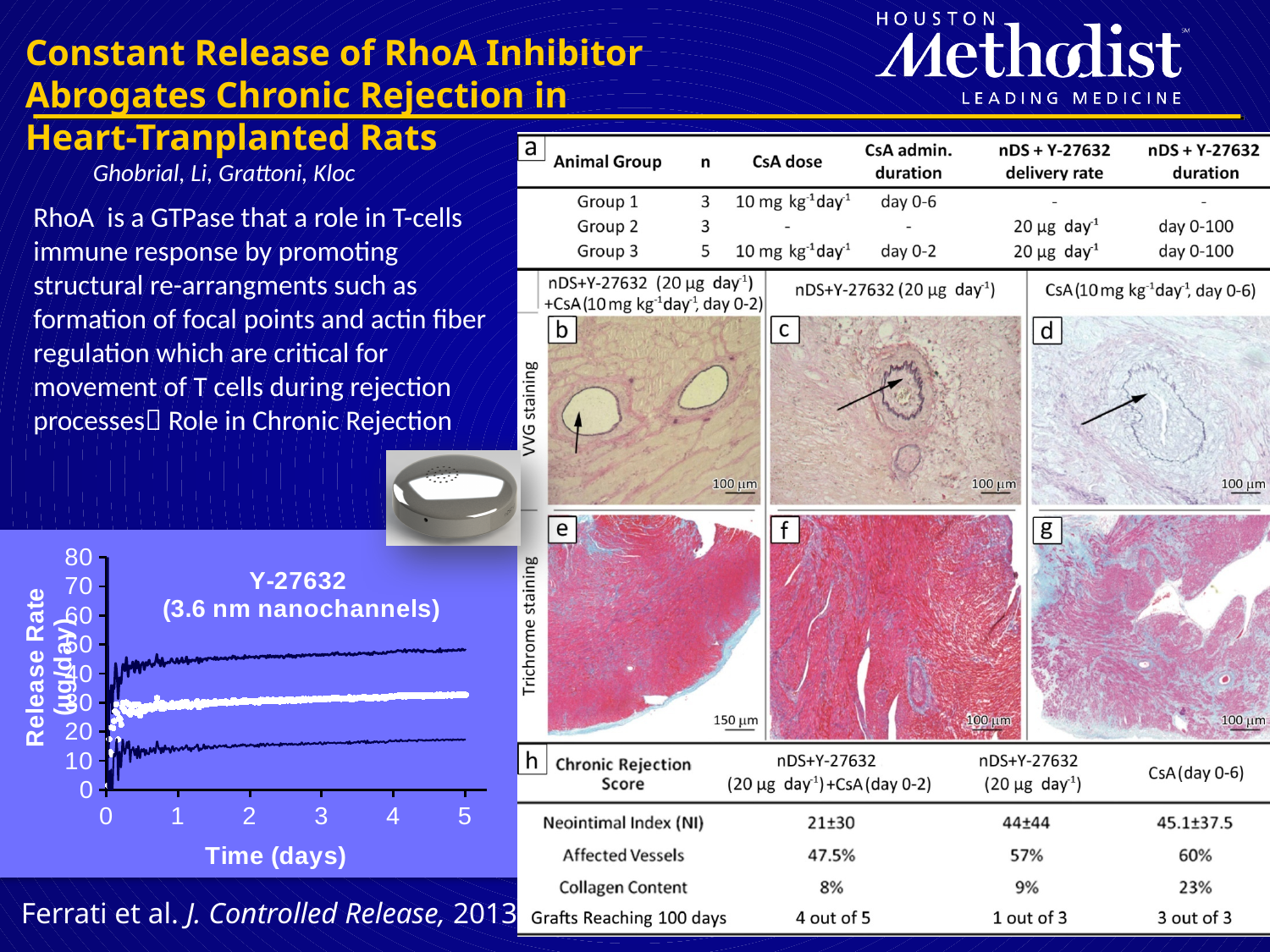
What is the title of the line chart at the bottom left of the slide? Y-27632 (3.6 nm nanochannels) What is the highest value shown on the y-axis of the Y-27632 line chart? 80 In the Y-27632 line chart, which line has the highest release rate at day 5, the top, middle or bottom line? top line What kind of chart is shown at the bottom left of the slide? line chart In the Y-27632 line chart, is the value of the middle (white) line at day 5 greater or less than 20? greater In the Y-27632 line chart, is the value of the middle (white) line at day 5 greater or less than 40? less In the Y-27632 line chart, is the value of the bottom line at day 5 greater or less than 20? less In the Y-27632 line chart, does the top line rise or fall between day 1 and day 5? rise What is the x-axis title of the Y-27632 line chart? Time (days) How many lines are plotted in the Y-27632 line chart? 3